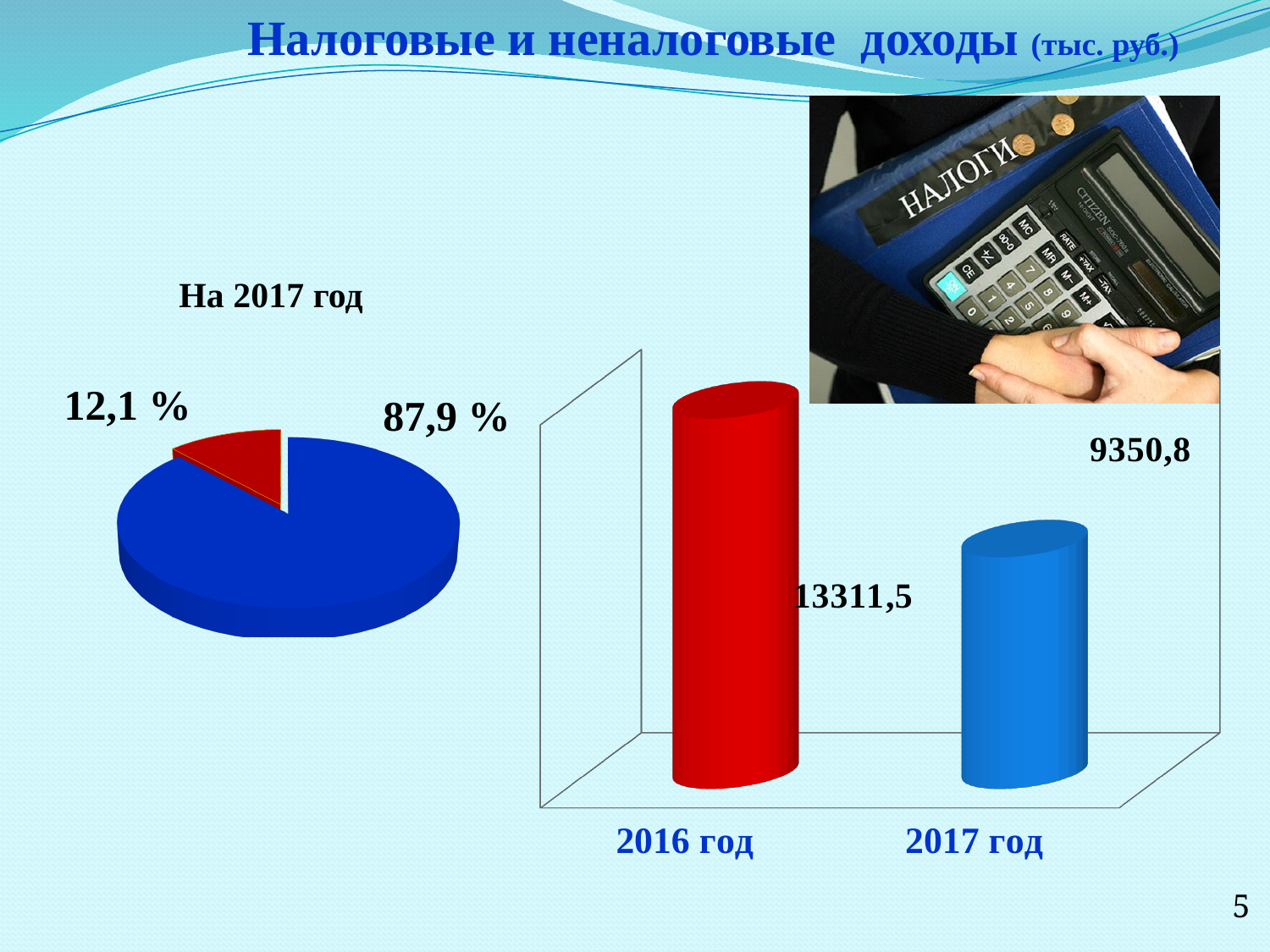
On the bar chart on the right, which year has the lower value? 2017 год On the bar chart on the right, what is the value for 2017 год? 9350,8 On the bar chart on the right, do the values rise or fall from 2016 год to 2017 год? fall On the bar chart on the right, how many bars are shown? 2 What is the title of the slide? Налоговые и неналоговые доходы (тыс. руб.) On the bar chart on the right, what is the difference between the values for 2016 год and 2017 год? 3960,7 On the bar chart on the right, is the value for 2017 год larger or smaller than the value for 2016 год? smaller On the pie chart titled 'На 2017 год', what share does the blue slice represent? 87,9 % On the bar chart on the right, which year has the higher value? 2016 год On the bar chart on the right, what is the value for 2016 год? 13311,5 On the pie chart titled 'На 2017 год', what share does the red slice represent? 12,1 % What kind of chart is shown on the right side of the slide? bar chart